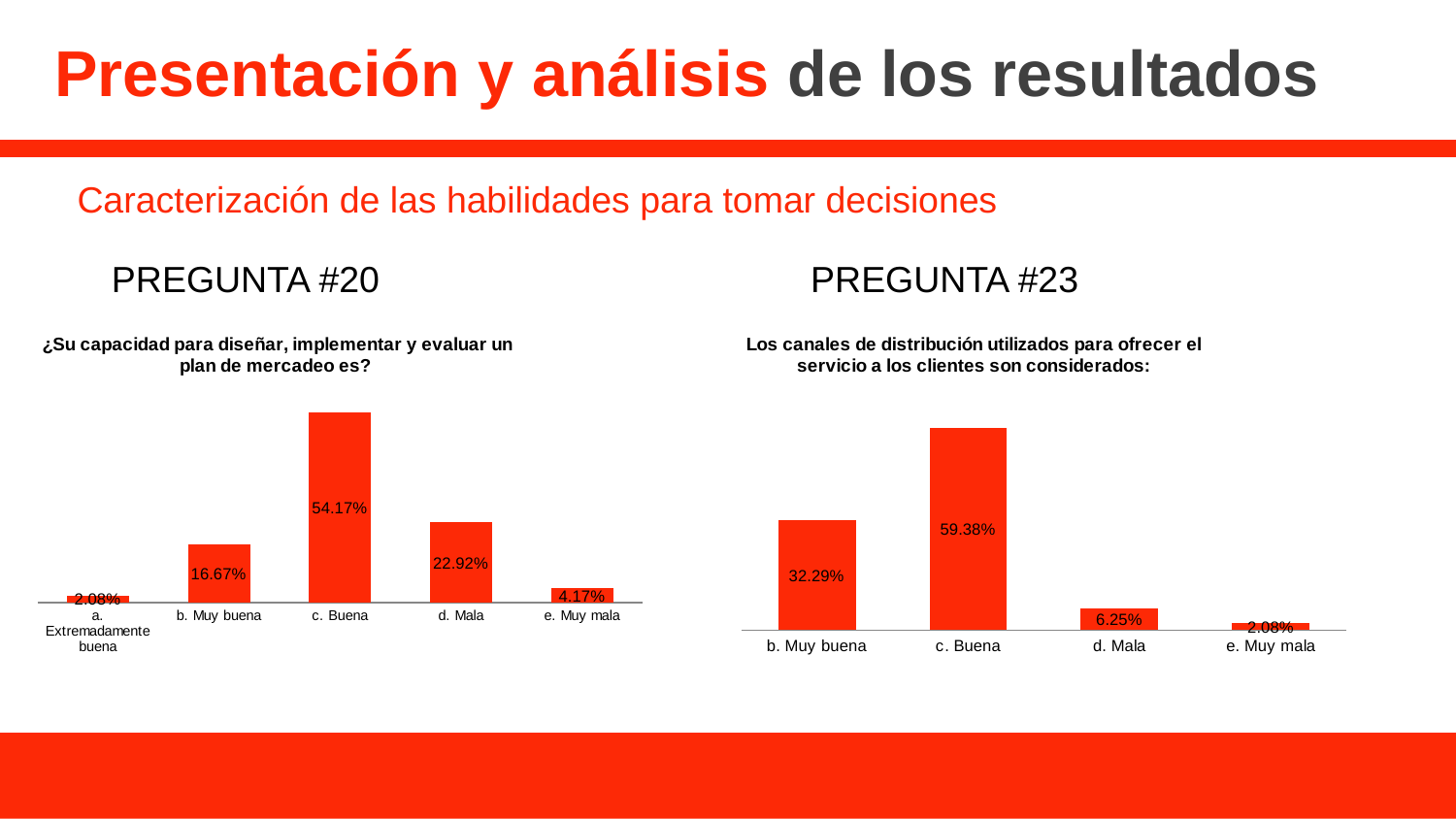
In the PREGUNTA #20 chart, what is the value for c. Buena? 54.17% In the PREGUNTA #20 chart, which category has the lowest value? a. Extremadamente buena In the PREGUNTA #23 chart, how many categories are shown? 4 In the PREGUNTA #23 chart, which is larger, d. Mala or e. Muy mala? d. Mala In the PREGUNTA #20 chart, what is the value for d. Mala? 22.92% In the PREGUNTA #20 chart, what is the difference between c. Buena and d. Mala? 31.25% In the PREGUNTA #23 chart, what is the value for b. Muy buena? 32.29% In the PREGUNTA #20 chart, which category has the highest value? c. Buena In the PREGUNTA #20 chart, how many categories are shown? 5 In the PREGUNTA #23 chart, which category has the highest value? c. Buena In the PREGUNTA #23 chart, what is the value for e. Muy mala? 2.08% What kind of chart is the PREGUNTA #23 chart? Bar chart